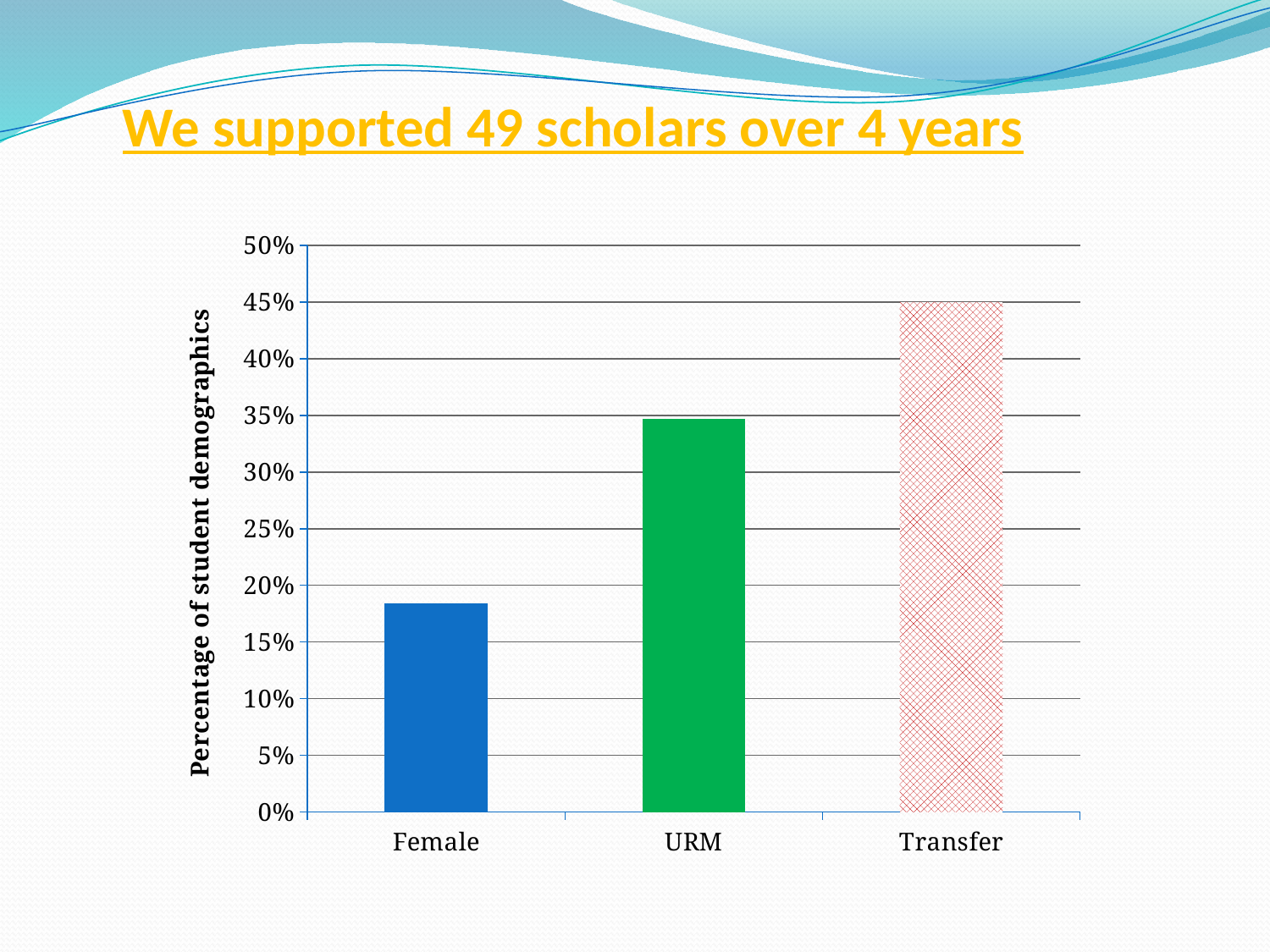
Which is larger, the value for Transfer or the value for URM? Transfer What is the title of the slide above the chart? We supported 49 scholars over 4 years Is the value for URM greater or less than 30%? greater Is the value for Transfer greater or less than 40%? greater What is the label of the vertical axis of the chart? Percentage of student demographics Which category has the lowest percentage in the chart? Female Is the value for Female greater or less than 20%? less What kind of chart is shown on the slide? bar chart Which is larger, the value for URM or the value for Female? URM Which category has the highest percentage in the chart? Transfer How many categories are shown on the x axis of the chart? 3